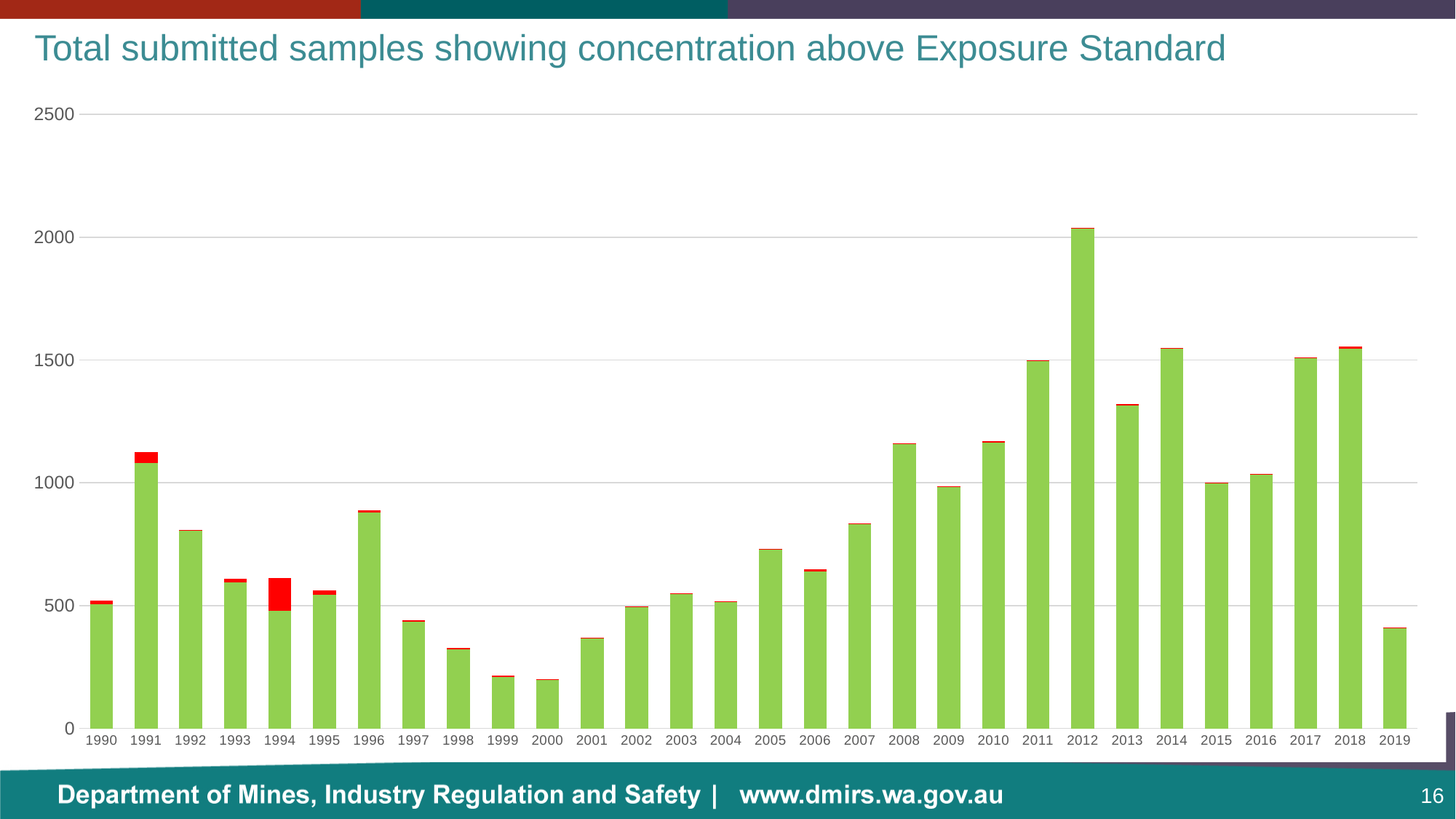
Is the value for 2013 greater or less than 1000? greater Which year has the highest bar in the chart? 2012 Do the bars generally rise or fall from 1996 to 2000? fall Is the value for 2012 greater or less than 2000? greater Which is larger, the bar for 2018 or the bar for 2019? 2018 What is the title of the chart? Total submitted samples showing concentration above Exposure Standard Which is larger, the bar for 2011 or the bar for 2012? 2012 Is the value for 2019 greater or less than 500? less What kind of chart is shown on the slide? bar chart How many years are shown along the x axis of the chart? 30 Which is larger, the bar for 1991 or the bar for 1992? 1991